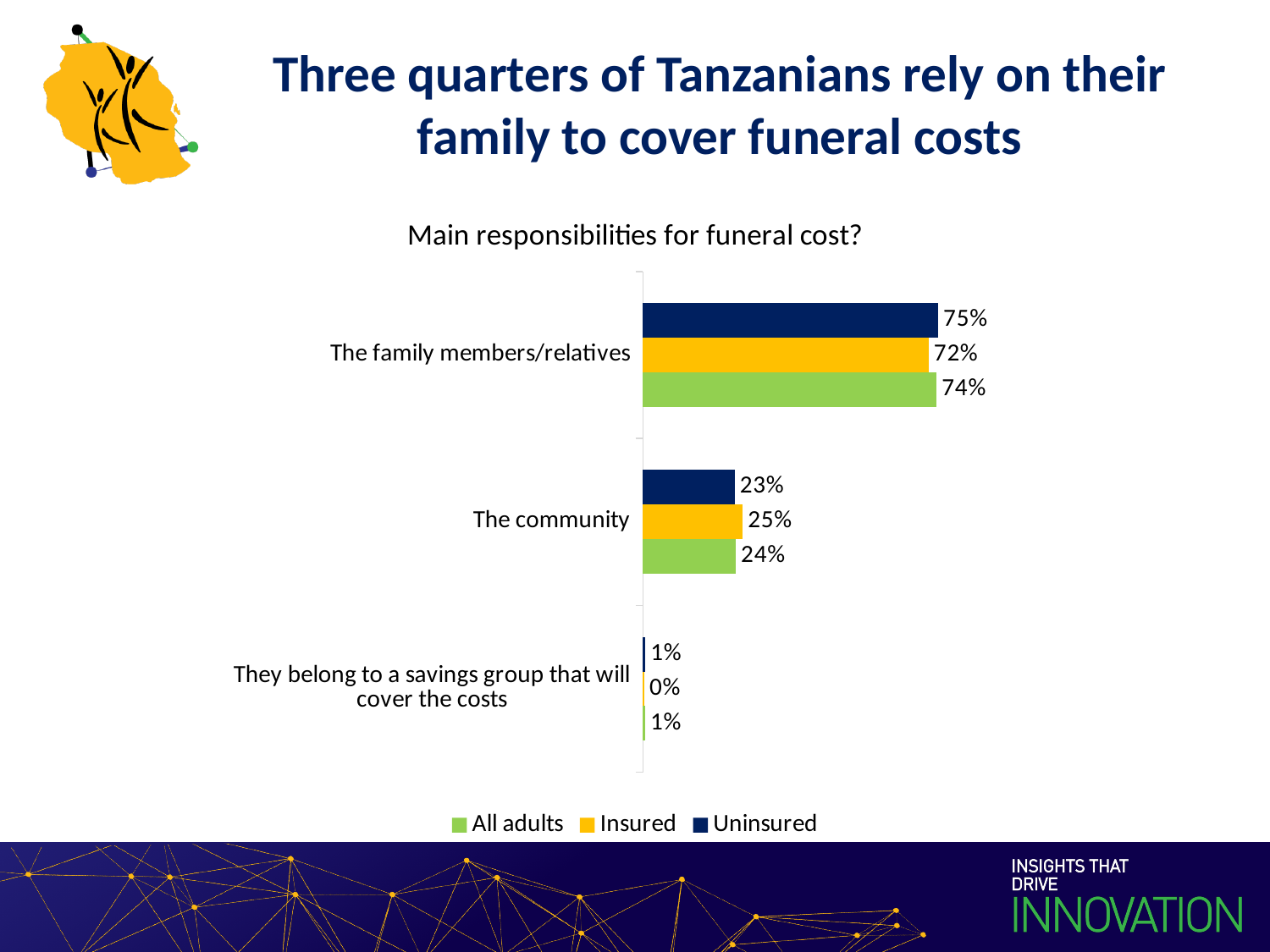
What is the value for All adults for 'They belong to a savings group that will cover the costs'? 1% How many categories are shown on the chart? 3 Which category has the lowest value for Uninsured? They belong to a savings group that will cover the costs What is the value for Insured for 'The community'? 25% For 'The community', which is larger: the Insured value or the Uninsured value? Insured How many series does the legend list? 3 What is the difference between the Uninsured and Insured values for 'The family members/relatives'? 3% What percentage of uninsured adults say family members/relatives are mainly responsible for funeral costs? 75% Which category has the highest value for All adults? The family members/relatives What kind of chart is shown on the slide? Bar chart What is the title of the chart? Main responsibilities for funeral cost? Which series is shown in green in the legend? All adults